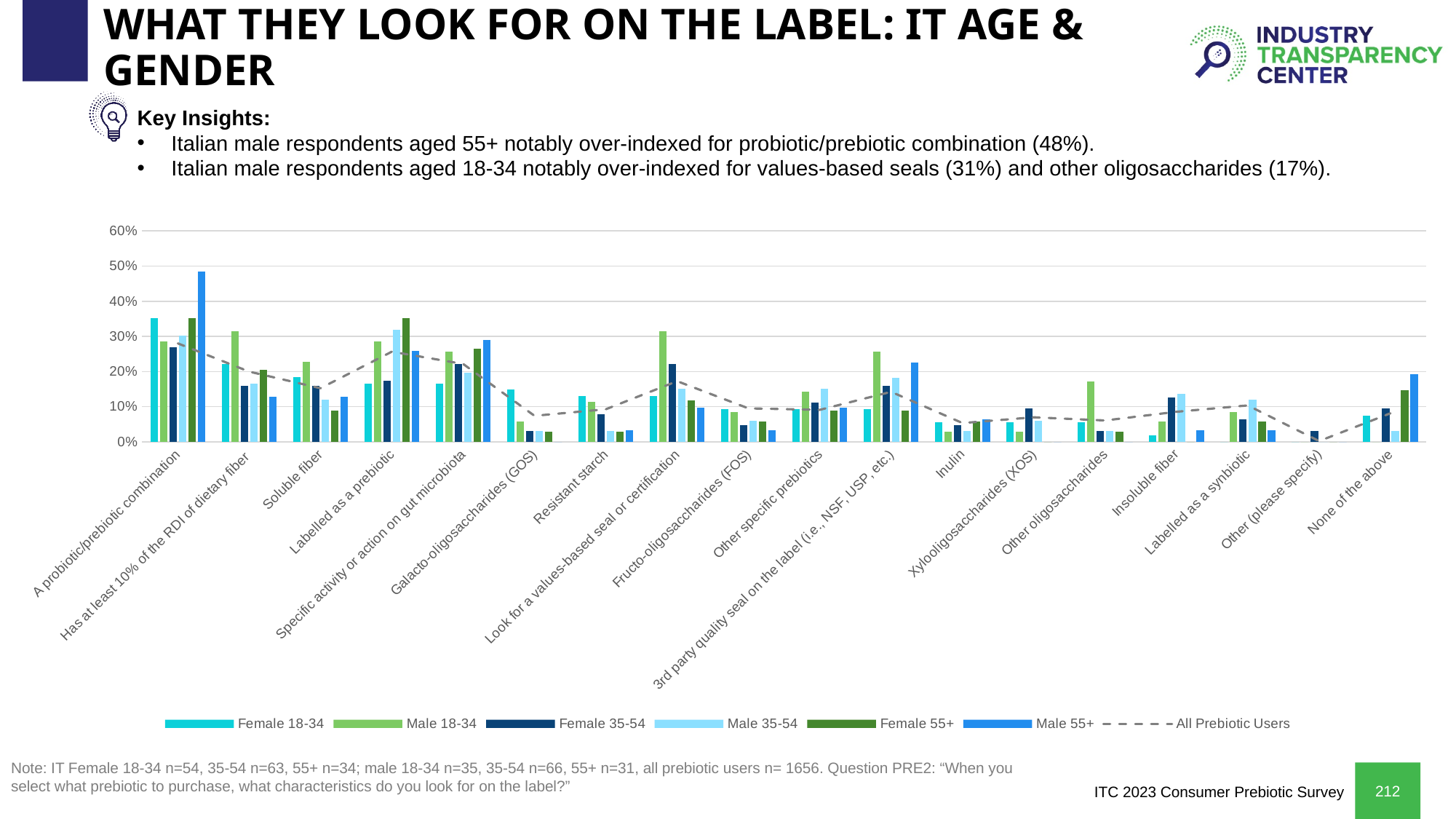
What kind of chart is shown on the slide? Bar chart (with a dashed line for All Prebiotic Users) How many series does the chart legend list? 7 Which series has the tallest bar for 'Look for a values-based seal or certification'? Male 18-34 How many categories are shown along the x axis of the chart? 18 Is the Male 18-34 value for 'Other oligosaccharides' greater or less than 10%? greater What does the dashed grey line in the chart represent, according to the legend? All Prebiotic Users Is the Male 55+ value for 'A probiotic/prebiotic combination' greater or less than 40%? greater Which series has the tallest bar for 'A probiotic/prebiotic combination'? Male 55+ For 'Other oligosaccharides', which is larger: the Male 18-34 value or the Female 35-54 value? Male 18-34 For 'None of the above', which is larger: the Male 55+ value or the Female 55+ value? Male 55+ Is the Female 18-34 value for 'A probiotic/prebiotic combination' greater or less than 30%? greater